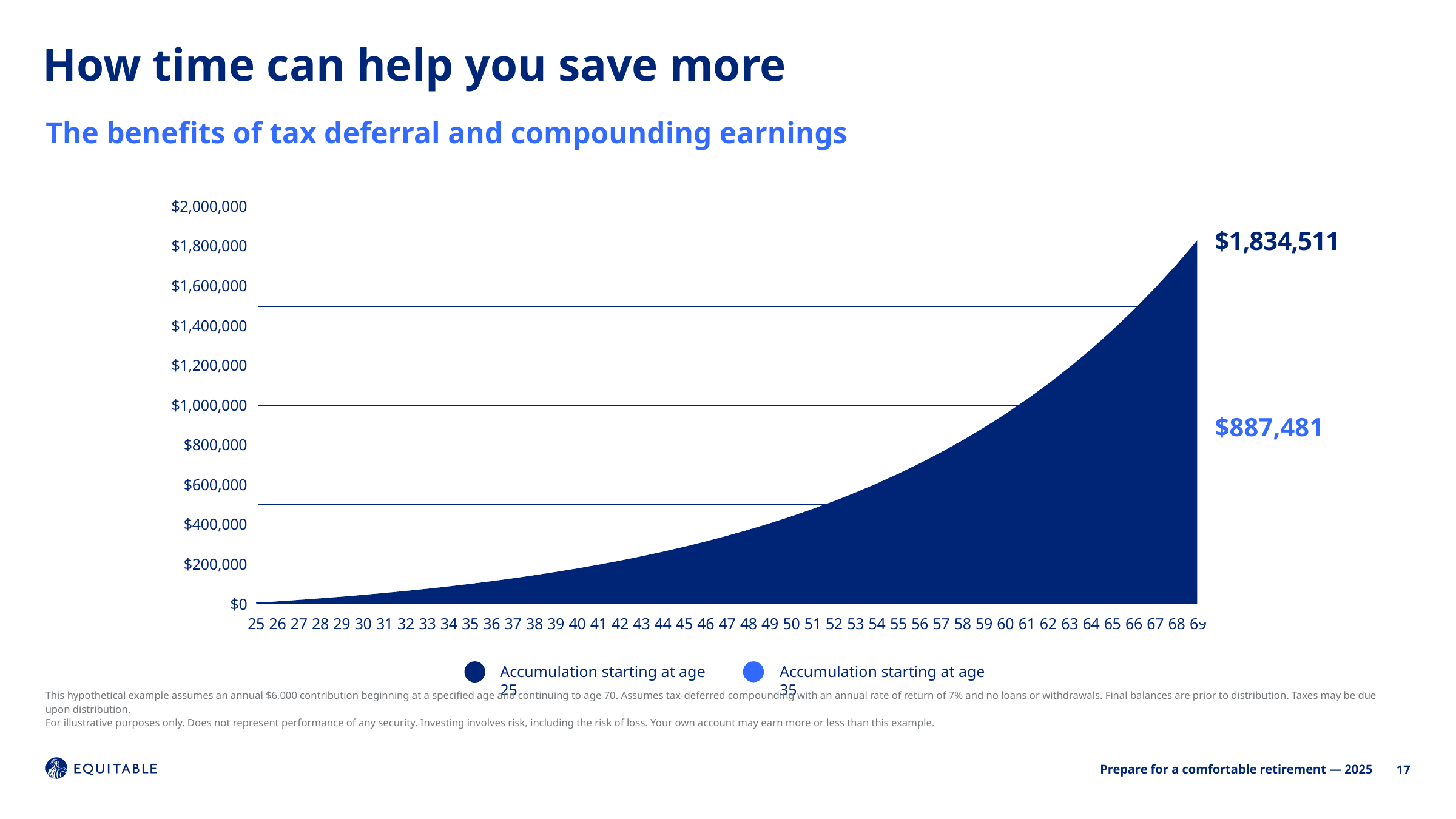
Does the accumulation starting at age 25 rise or fall as age increases along the x axis? Rises How many series does the legend list? 2 What is the difference between the final values for accumulation starting at age 25 and accumulation starting at age 35? $947,030 Which series ends with the larger final value: accumulation starting at age 25 or accumulation starting at age 35? Accumulation starting at age 25 What is the title of the slide containing the chart? How time can help you save more What is the highest value labelled on the y axis? $2,000,000 Is the value of the accumulation starting at age 25 at age 50 greater or less than $600,000? less Is the value of the accumulation starting at age 25 at age 65 greater or less than $1,000,000? greater What is the final accumulation value shown for the series starting at age 35? $887,481 What is the final accumulation value shown for the series starting at age 25? $1,834,511 Is the value of the accumulation starting at age 25 at age 40 greater or less than $400,000? less What kind of chart is shown on the slide? Area chart